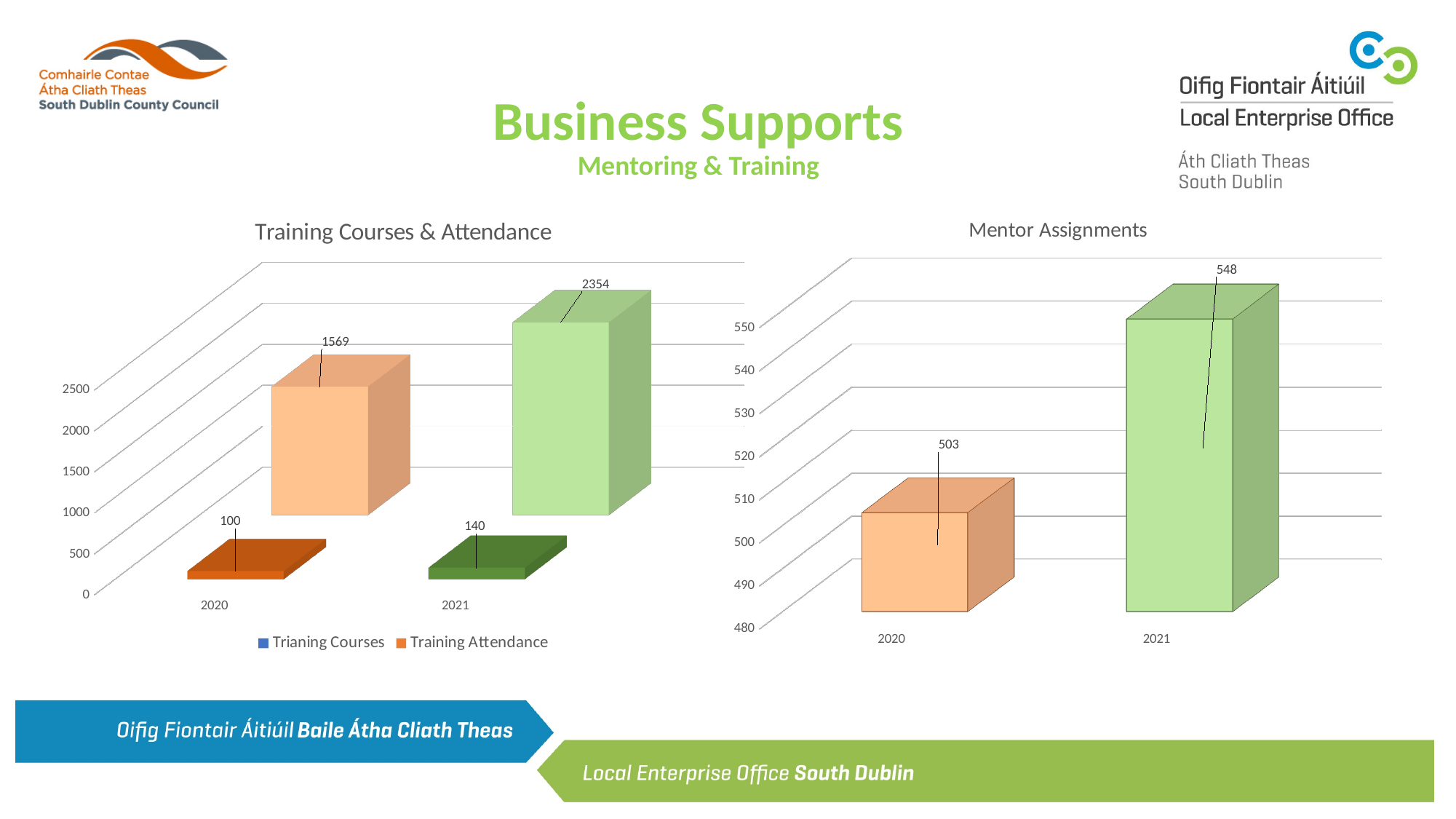
In the Training Courses & Attendance chart, by how much did Training Attendance increase from 2020 to 2021? 785 In the Mentor Assignments chart, which year has the higher value? 2021 In the Training Courses & Attendance chart, how many series does the legend list? 2 In the Training Courses & Attendance chart, what is the Training Courses value for 2021? 140 In the Mentor Assignments chart, what is the value for 2020? 503 In the Mentor Assignments chart, what is the value for 2021? 548 What kind of chart is the Mentor Assignments chart? bar chart In the Training Courses & Attendance chart, what is the Training Attendance value for 2020? 1569 In the Mentor Assignments chart, what is the difference between the 2021 and 2020 values? 45 In the Training Courses & Attendance chart, what is the Training Courses value for 2020? 100 In the Training Courses & Attendance chart, what is the Training Attendance value for 2021? 2354 In the Training Courses & Attendance chart, do the Training Courses values rise or fall from 2020 to 2021? rise